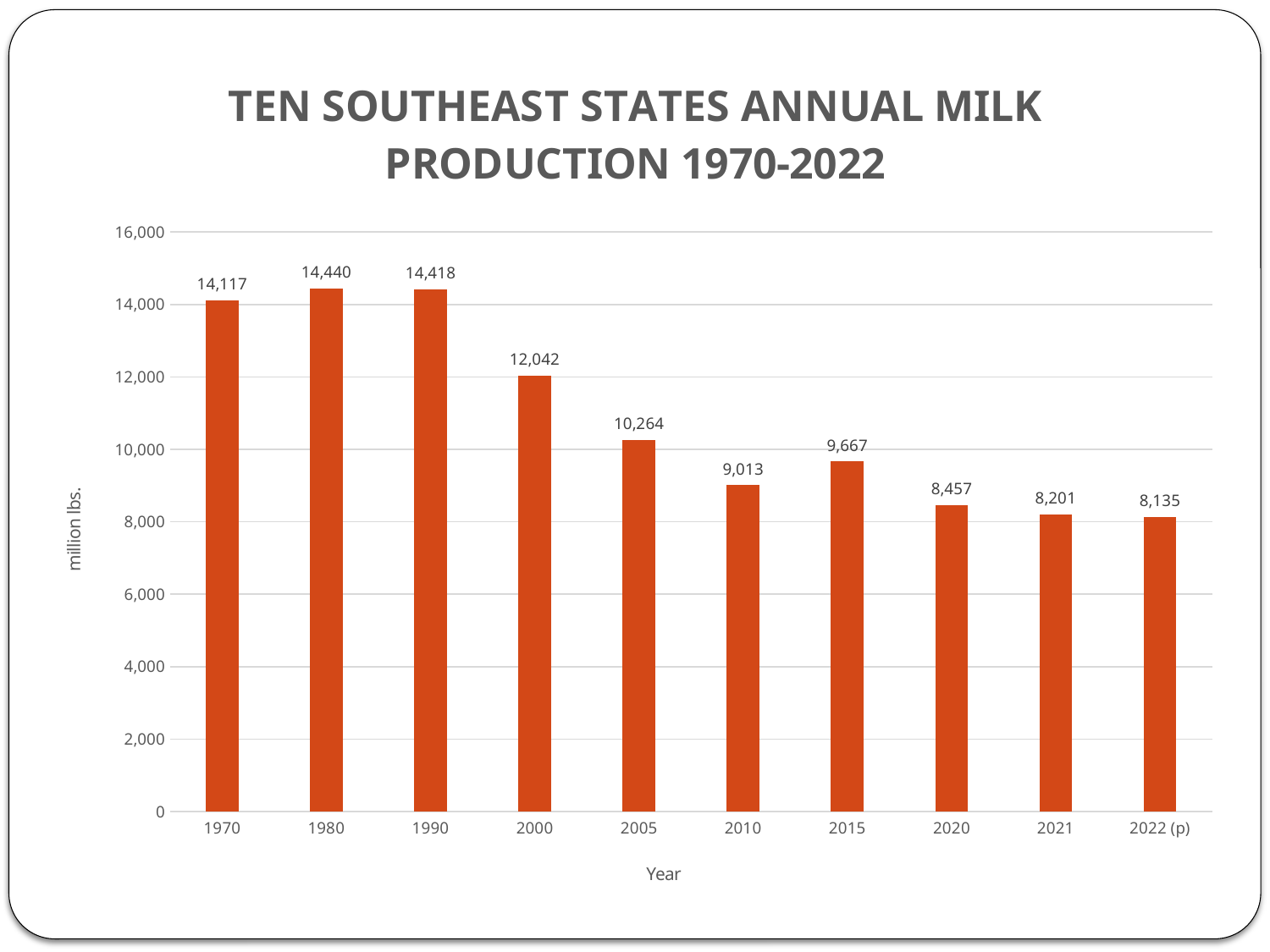
Do the values generally rise or fall from 1990 to 2022 (p)? fall Which year has the highest milk production? 1980 What is the difference between the 1970 value and the 2020 value? 5,660 Which year has the lowest milk production? 2022 (p) What value is shown for 2022 (p)? 8,135 What kind of chart is this? bar chart What is the title of the chart? TEN SOUTHEAST STATES ANNUAL MILK PRODUCTION 1970-2022 Which is larger, the value for 2005 or the value for 2015? 2005 What was the milk production in 2000? 12,042 Is the value for 2010 greater or less than 10,000? less How many years are shown on the x axis? 10 What is the label on the y axis? million lbs.